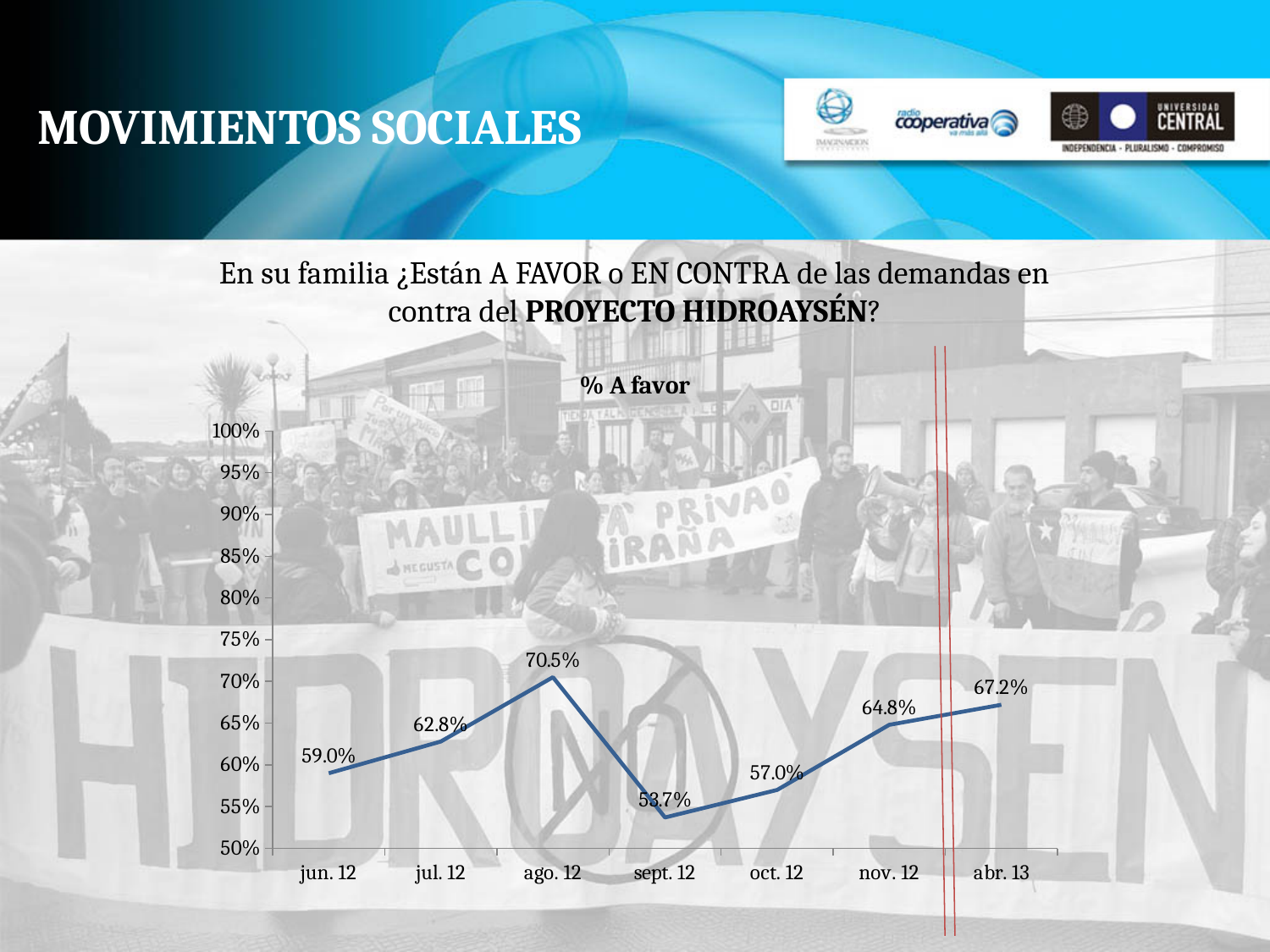
What is the value for abr. 13? 67.2% Which month has the highest value? ago. 12 What kind of chart is shown? line chart Is the value for oct. 12 greater or less than 60%? less Which month has the lowest value? sept. 12 What is the difference between the values for ago. 12 and sept. 12? 16.8% Which is larger, the value for nov. 12 or the value for abr. 13? abr. 13 What is the value for ago. 12? 70.5% What is the value for sept. 12? 53.7% How many data points are plotted on the chart? 7 What is the title of the chart? % A favor Do the values rise or fall from sept. 12 to abr. 13? rise